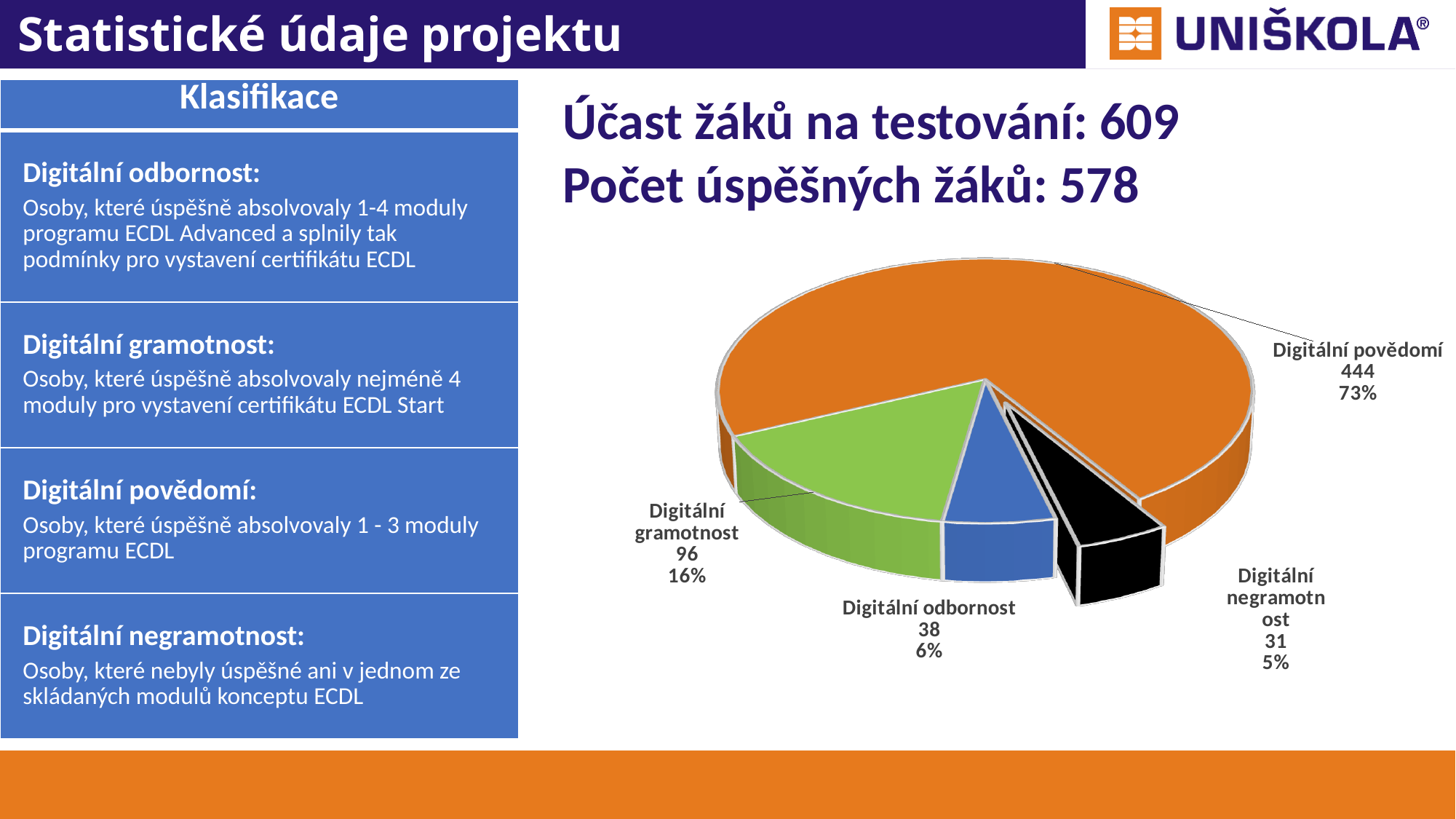
What colour is the Digitální gramotnost slice in the pie chart? green What percentage share does Digitální negramotnost have in the pie chart? 5% What is the value for Digitální odbornost in the pie chart? 38 What kind of chart is shown on the slide? pie chart What is the value for Digitální povědomí in the pie chart? 444 Which is larger in the pie chart, Digitální odbornost or Digitální negramotnost? Digitální odbornost What percentage share does Digitální gramotnost have in the pie chart? 16% How many slices does the pie chart have? 4 Which category has the largest slice in the pie chart? Digitální povědomí What percentage share does Digitální povědomí have in the pie chart? 73% What is the difference between the values for Digitální gramotnost and Digitální odbornost? 58 Which category has the smallest slice in the pie chart? Digitální negramotnost